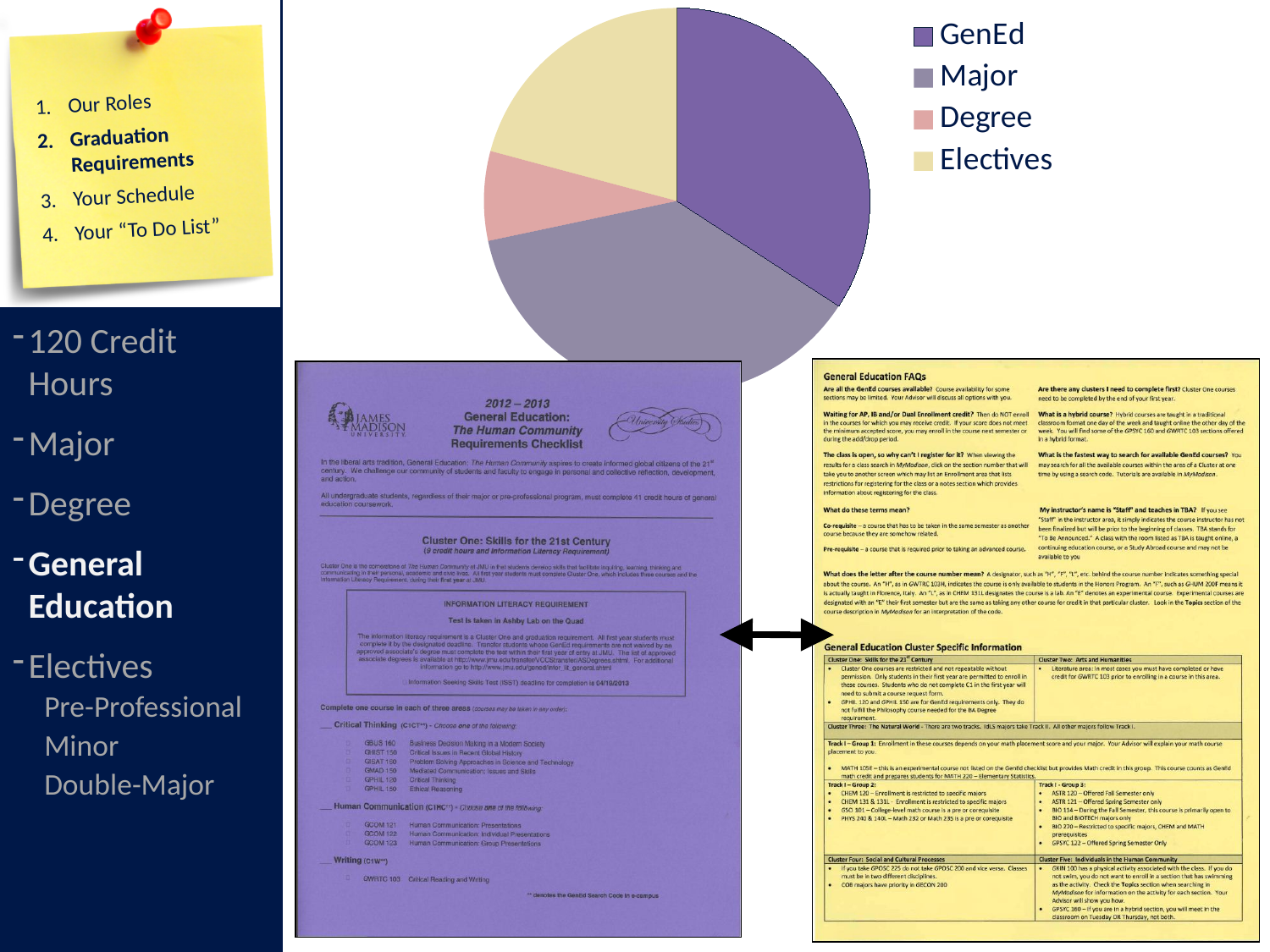
What colour is the GenEd slice in the pie chart? purple What kind of chart is shown on the slide? pie chart Which category does the pink slice of the pie chart represent? Degree How many slices does the pie chart have? 4 Which slice is larger in the pie chart, Major or Degree? Major Which slice is larger in the pie chart, GenEd or Degree? GenEd Which category has the smallest slice in the pie chart? Degree Which slice is larger in the pie chart, GenEd or Electives? GenEd How many entries does the pie chart's legend list? 4